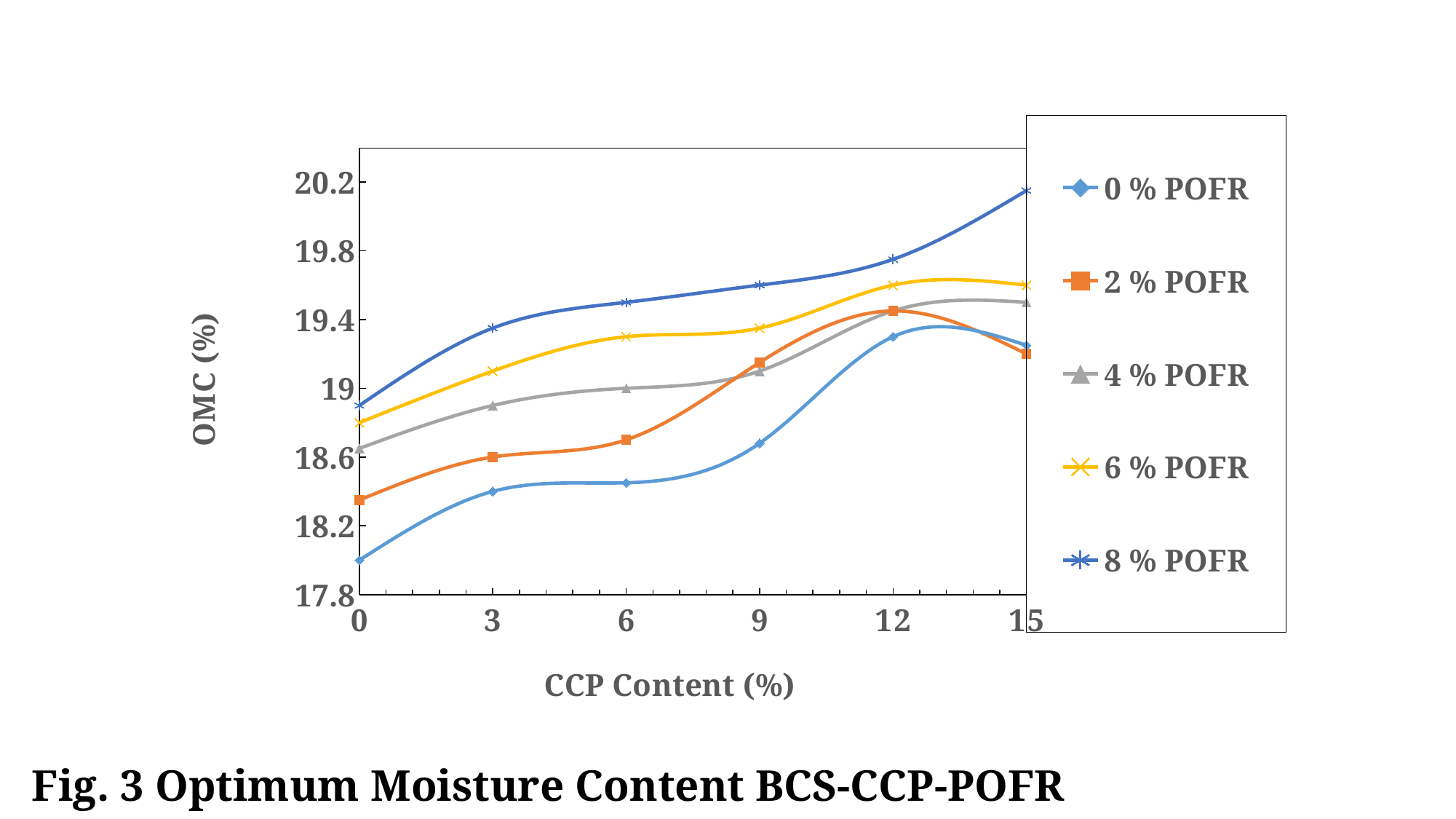
Is the OMC value for 2 % POFR at a CCP Content of 9% greater or less than 19? greater Which series has the highest OMC at a CCP Content of 15%? 8 % POFR Is the OMC value for 6 % POFR at a CCP Content of 0% greater or less than 19? less Is the OMC value for 8 % POFR at a CCP Content of 15% greater or less than 19.8? greater How many CCP Content values are plotted along the x axis for each series? 6 How many series does the legend list? 5 What is the label of the x axis? CCP Content (%) At a CCP Content of 12%, which series has the larger OMC, 2 % POFR or 0 % POFR? 2 % POFR Does the OMC for 8 % POFR rise or fall as CCP Content increases from 0% to 15%? rise What kind of chart is shown on the slide? line chart Which series has the lowest OMC at a CCP Content of 0%? 0 % POFR